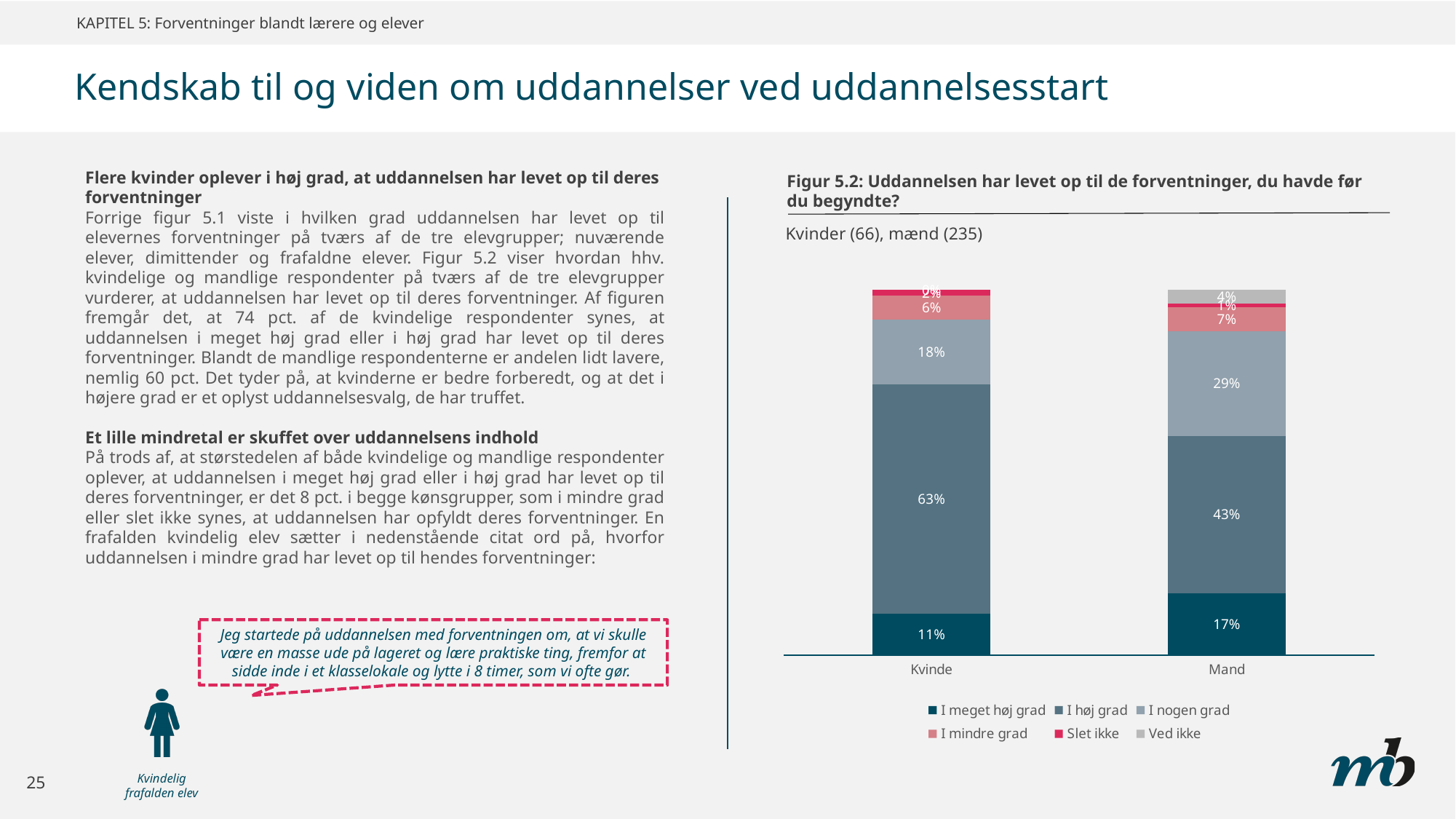
How many series does the legend of Figur 5.2 list? 6 What is the value for 'I høj grad' for Mand? 43% What is the value for 'I mindre grad' for Mand? 7% How many categories are shown on the x axis of Figur 5.2? 2 What is the difference between the 'I meget høj grad' values for Mand and Kvinde? 6% What is the value for 'I nogen grad' for Kvinde? 18% What kind of chart is shown in Figur 5.2? Stacked bar chart What is the value for 'Ved ikke' for Mand? 4% What is the difference between the 'I nogen grad' values for Mand and Kvinde? 11% Which category has the larger value for 'I høj grad', Kvinde or Mand? Kvinde What is the value for 'I meget høj grad' for Kvinde? 11% What is the title of the chart on the slide? Figur 5.2: Uddannelsen har levet op til de forventninger, du havde før du begyndte?